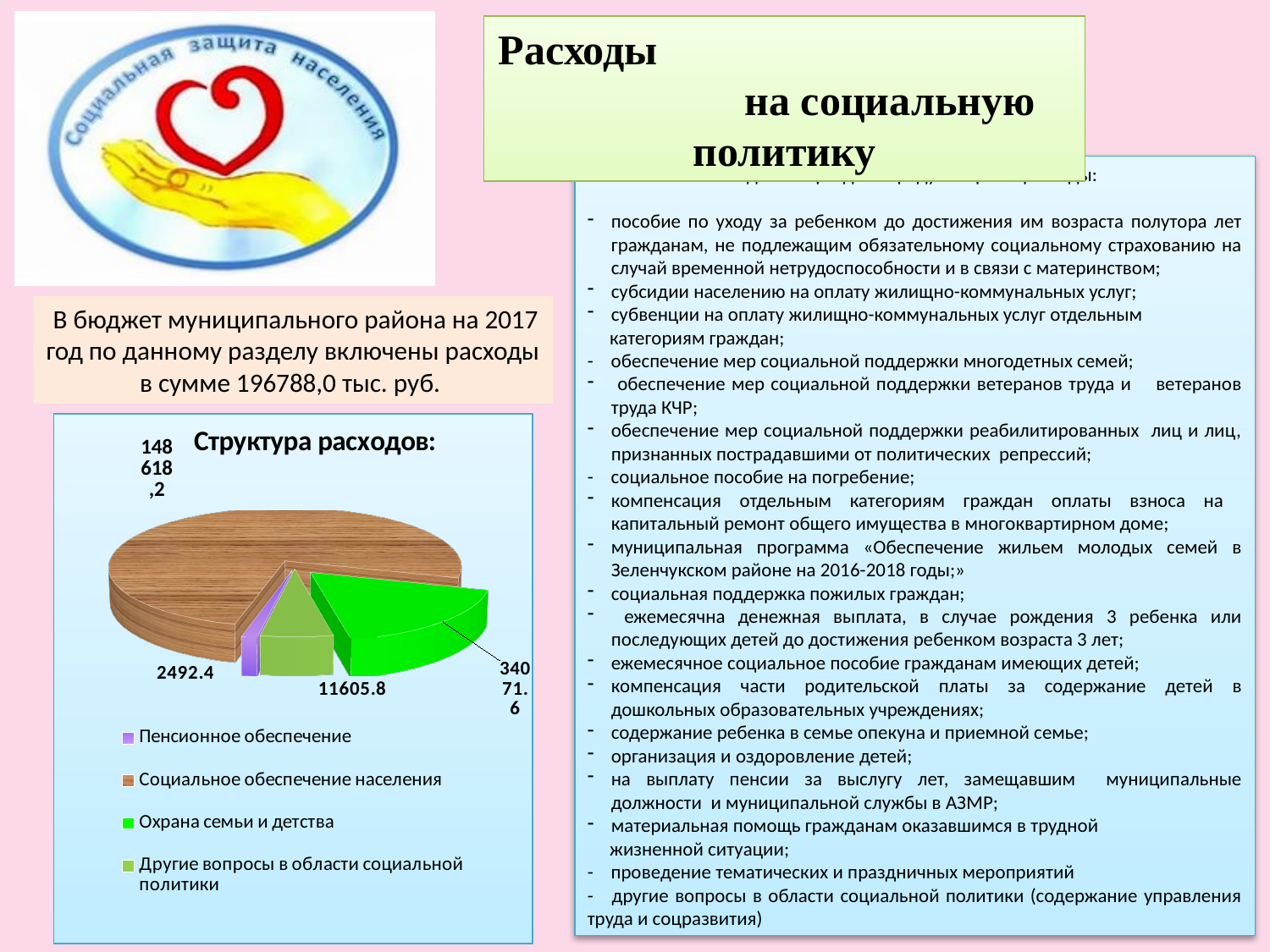
What is the value for "Охрана семьи и детства" in the pie chart? 34071.6 How many categories does the pie chart "Структура расходов:" show? 4 What is the value for "Другие вопросы в области социальной политики" in the pie chart? 11605.8 What kind of chart is shown under the title "Структура расходов:"? pie chart What is the value for "Социальное обеспечение населения" in the pie chart? 148618,2 Which category has the smallest slice in the pie chart "Структура расходов:"? Пенсионное обеспечение What is the value for "Пенсионное обеспечение" in the pie chart? 2492.4 In the pie chart, which is larger: "Охрана семьи и детства" or "Другие вопросы в области социальной политики"? Охрана семьи и детства What is the title of the pie chart on the slide? Структура расходов: What colour represents "Охрана семьи и детства" in the pie chart legend? green What is the difference between the values for "Другие вопросы в области социальной политики" and "Пенсионное обеспечение" in the pie chart? 9113.4 Which category has the largest slice in the pie chart "Структура расходов:"? Социальное обеспечение населения